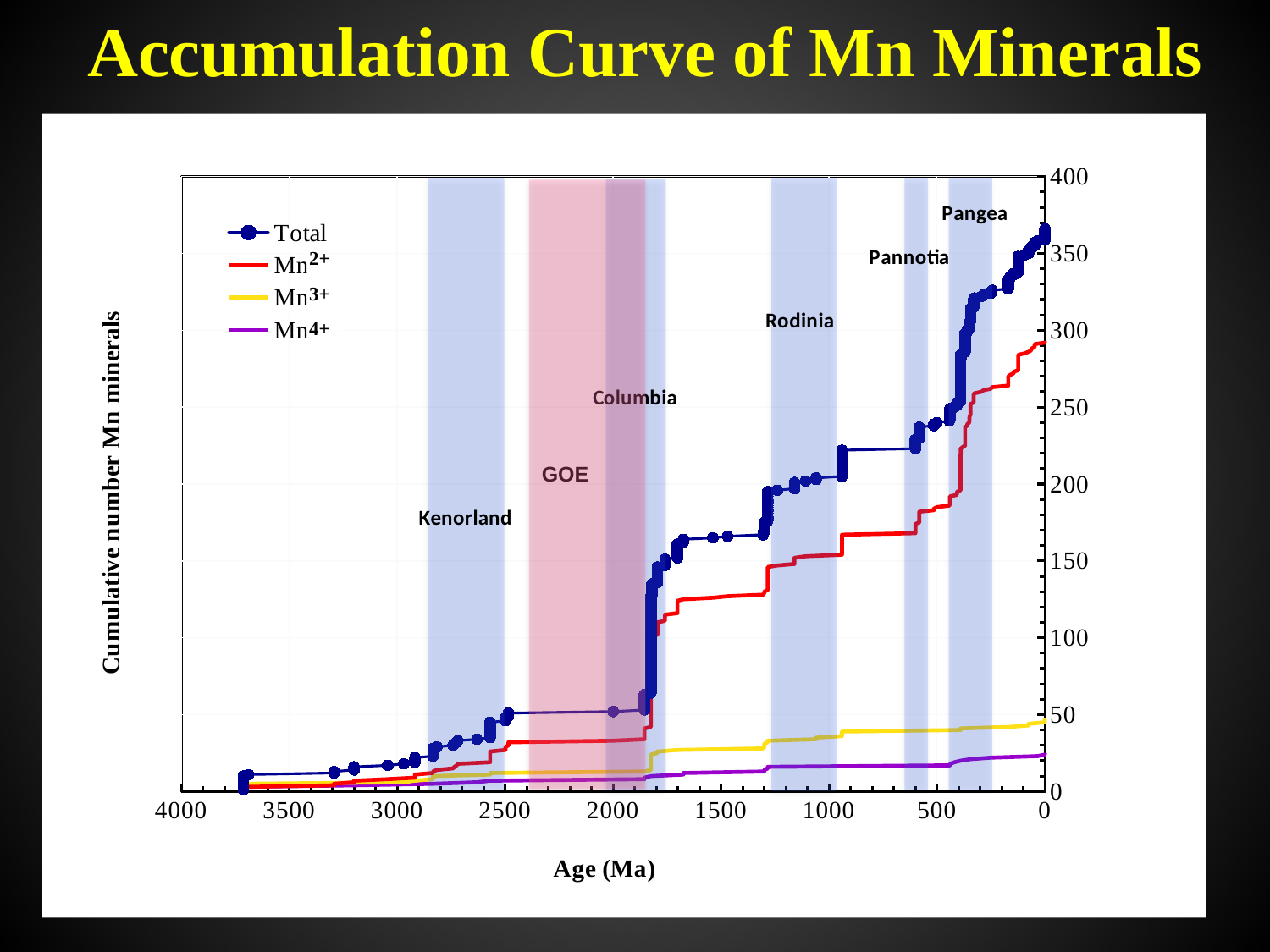
Which series has the lowest values across the chart? Mn4+ Is the value of the Mn4+ series at 0 Ma greater or less than 50? less At 0 Ma, which series has the larger value, Mn3+ or Mn4+? Mn3+ Is the value of the Total series at 0 Ma greater or less than 350? greater How many series does the legend list? 4 What is the label of the x axis? Age (Ma) What is the label of the y axis? Cumulative number Mn minerals Moving from left to right along the x axis (from 4000 Ma to 0 Ma), does the Total curve rise or fall? rise What kind of chart is shown on the slide? line chart Which series reaches the highest value on the chart? Total Is the value of the Mn2+ series at 0 Ma greater or less than 300? less